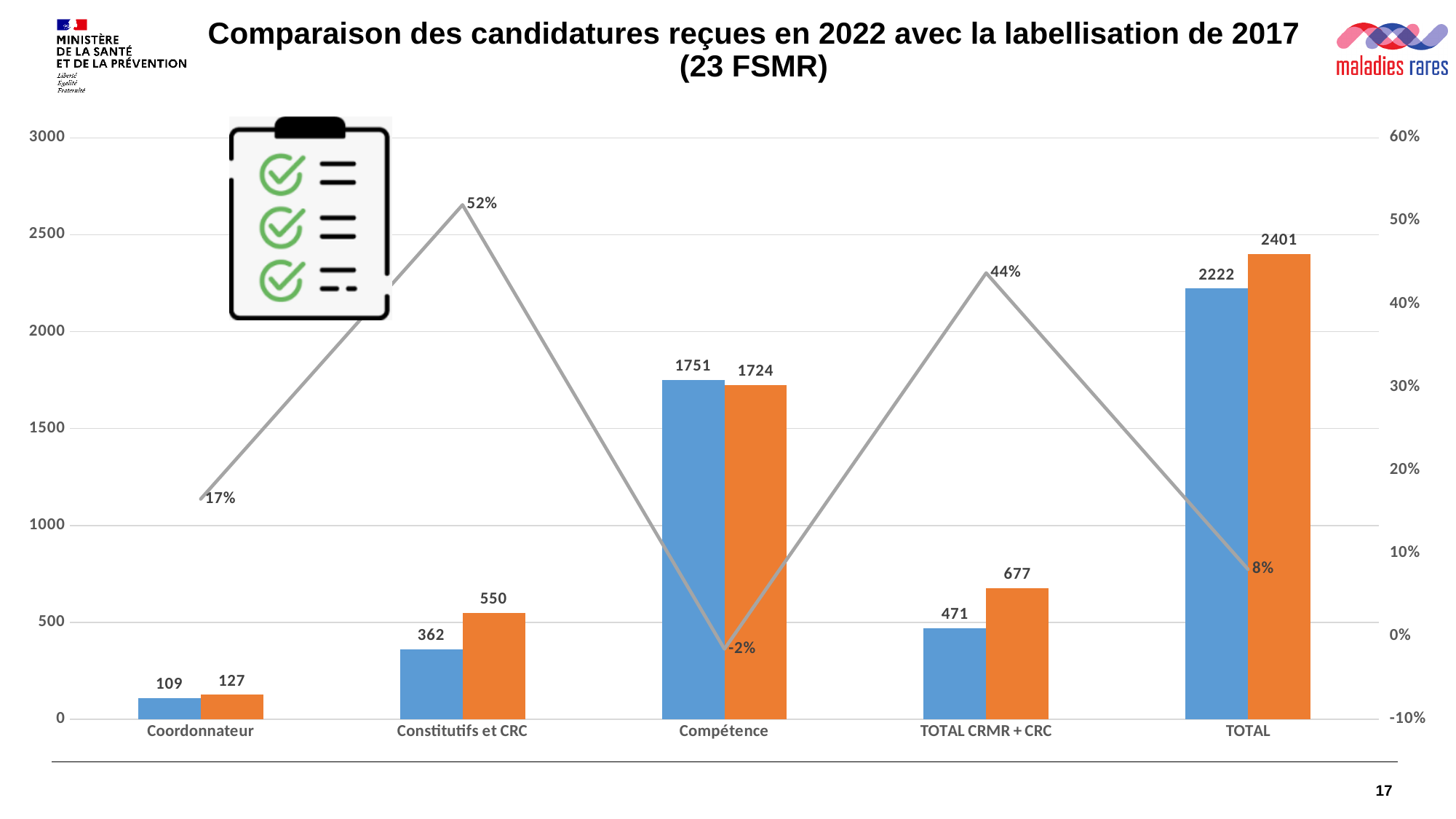
What percentage does the grey line show for TOTAL CRMR + CRC? 44% What kind of chart is shown on the slide? a bar chart combined with a line What is the title of the chart? Comparaison des candidatures reçues en 2022 avec la labellisation de 2017 (23 FSMR) What is the value of the blue bar for Coordonnateur? 109 What is the value of the orange bar for Compétence? 1724 For Compétence, which bar is larger, the blue bar or the orange bar? the blue bar Is the value of the blue bar for TOTAL CRMR + CRC greater or less than 500? less Which category has the highest percentage on the grey line? Constitutifs et CRC How many categories are shown on the x axis? 5 What is the difference between the orange bar and the blue bar for TOTAL? 179 Which category has the lowest percentage on the grey line? Compétence What is the value of the orange bar for Constitutifs et CRC? 550